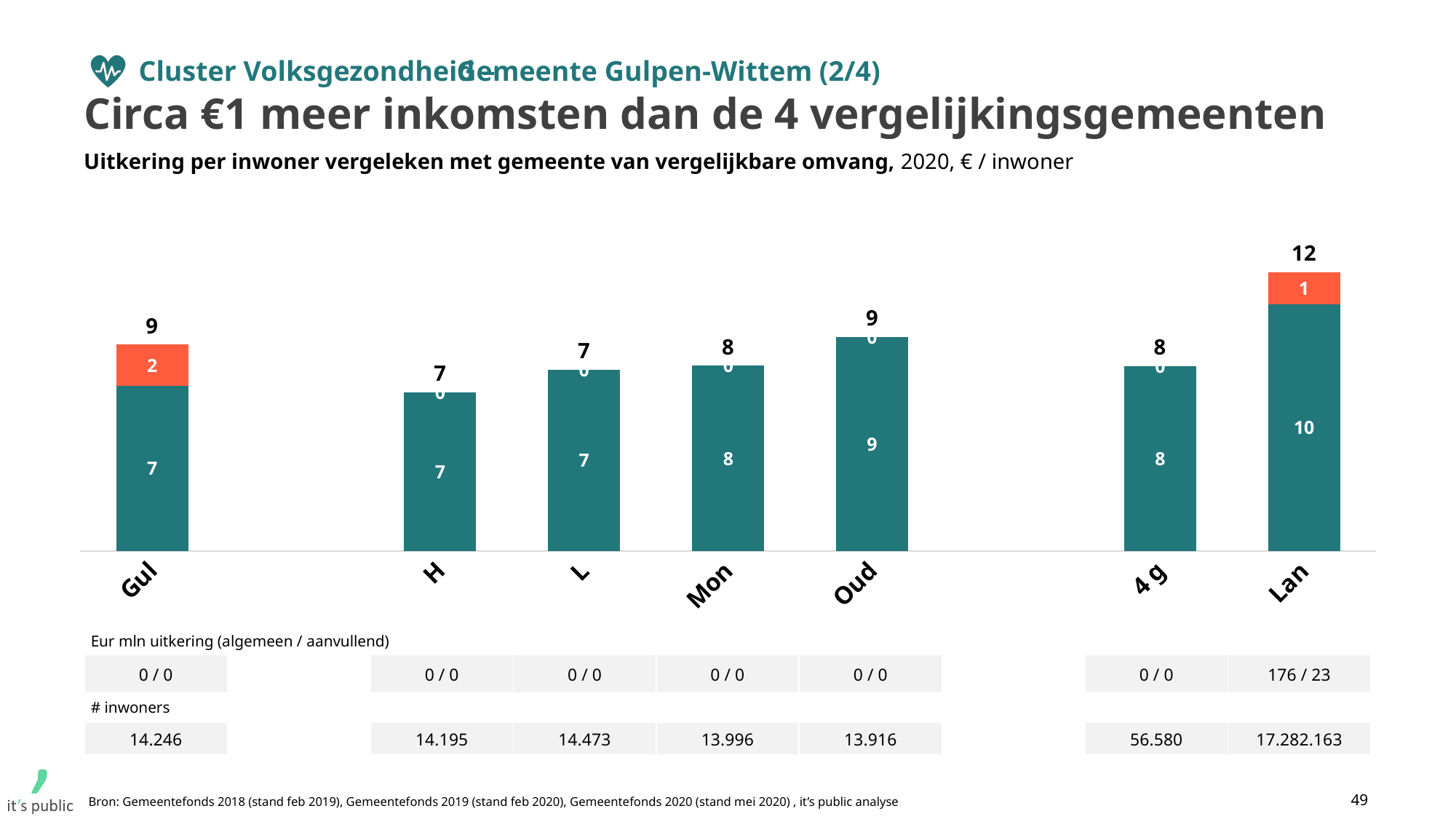
What is the total value shown above the bar for Lan? 12 What is the value of the teal (bottom) segment of the Lan bar? 10 What is the value of the orange (top) segment of the H bar? 0 What is the value of the teal (bottom) segment of the Oud bar? 9 What is the total value shown above the bar for 4 g? 8 What is the value of the orange (top) segment of the Gul bar? 2 How many categories are shown on the x axis? 7 Which category has the highest total value? Lan Which is larger, the total for Mon or the total for Oud? Oud What is the total value shown above the bar for Gul? 9 What kind of chart is shown on the slide? Stacked bar chart What is the difference between the total for Lan and the total for Gul? 3